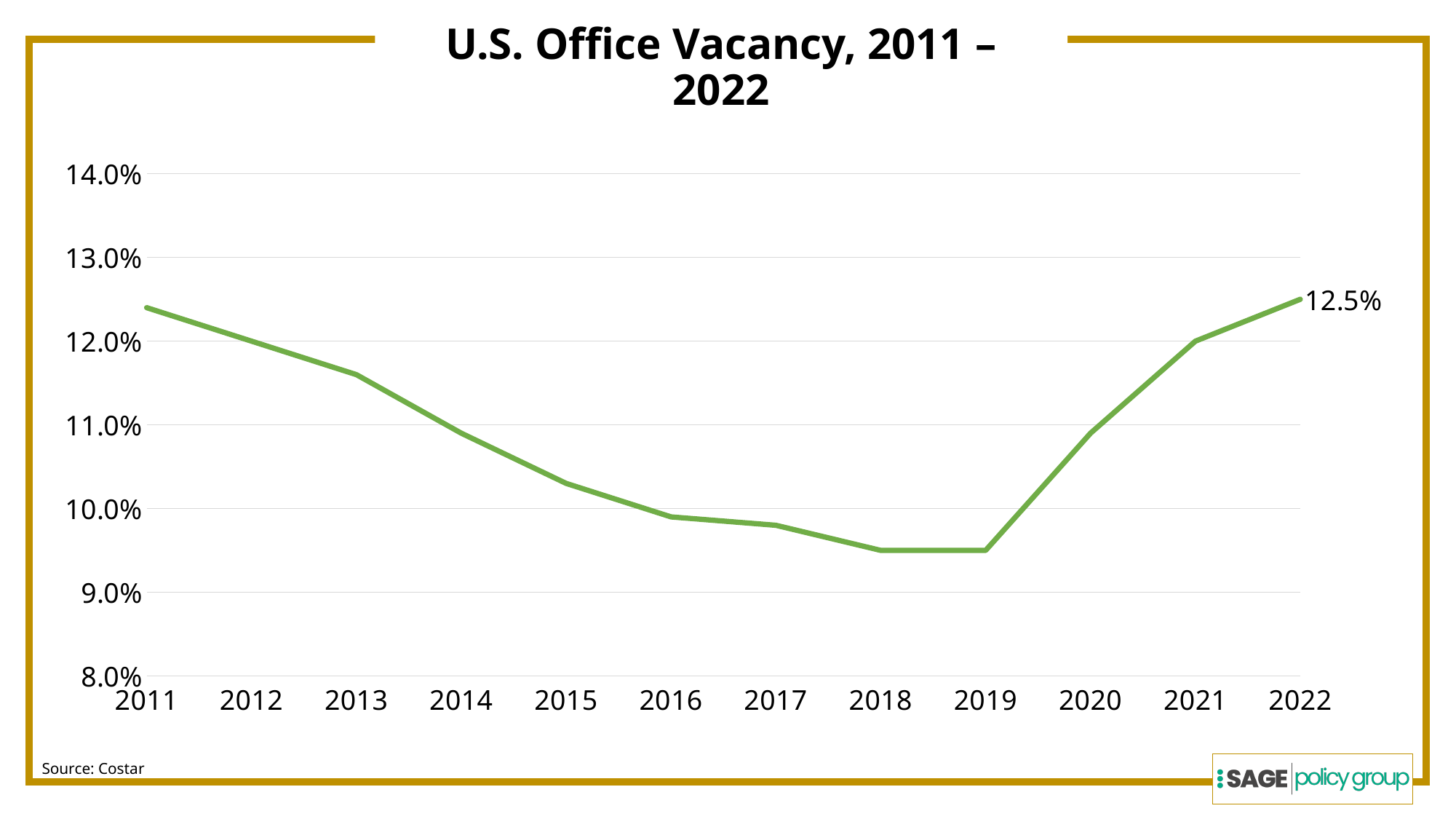
Is the value for 2018 greater or less than 10.0%? less Which year has the higher vacancy rate, 2019 or 2021? 2021 Is the value for 2011 greater or less than 12.0%? greater Does the vacancy rate rise or fall from 2011 to 2019? fall What source is cited for the chart data? Costar What is the U.S. office vacancy rate shown for 2022? 12.5% How many years are plotted on the chart? 12 Which year has the higher vacancy rate, 2013 or 2016? 2013 Is the value for 2015 greater or less than 10.0%? greater What is the U.S. office vacancy rate shown for 2021? 12.0% What kind of chart is shown on the slide? line chart